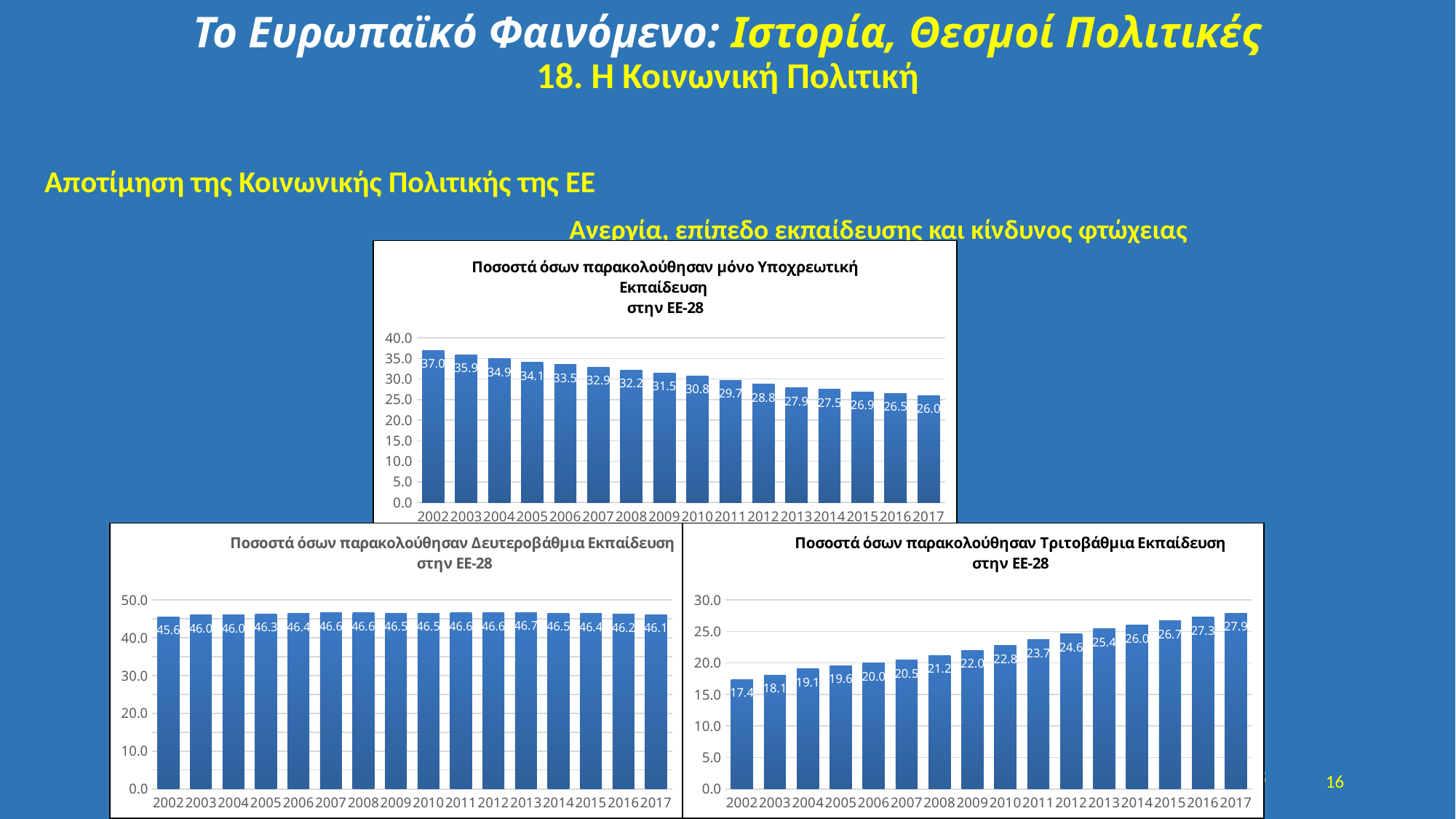
In the bottom-left chart (Δευτεροβάθμια Εκπαίδευση), is the value for 2010 greater or less than 40.0? greater In the top chart (Ποσοστά όσων παρακολούθησαν μόνο Υποχρεωτική Εκπαίδευση στην ΕΕ-28), what is the value for 2002? 37.0 In the bottom-left chart (Δευτεροβάθμια Εκπαίδευση στην ΕΕ-28), what is the value for 2013? 46.7 In the bottom-right chart (Τριτοβάθμια Εκπαίδευση), do the values rise or fall from 2002 to 2017? rise In the bottom-right chart (Τριτοβάθμια Εκπαίδευση στην ΕΕ-28), what is the value for 2017? 27.9 In the top chart (μόνο Υποχρεωτική Εκπαίδευση), what is the value for 2017? 26.0 In the top chart (μόνο Υποχρεωτική Εκπαίδευση), what is the difference between the 2002 and 2017 values? 11.0 In the bottom-left chart (Δευτεροβάθμια Εκπαίδευση), what is the value for 2002? 45.6 In the top chart (μόνο Υποχρεωτική Εκπαίδευση), which year has the lowest value? 2017 In the top chart (μόνο Υποχρεωτική Εκπαίδευση), do the values rise or fall from 2002 to 2017? fall How many years (bars) are shown in the bottom-right chart (Τριτοβάθμια Εκπαίδευση)? 16 In the bottom-right chart (Τριτοβάθμια Εκπαίδευση), which year has the highest value? 2017